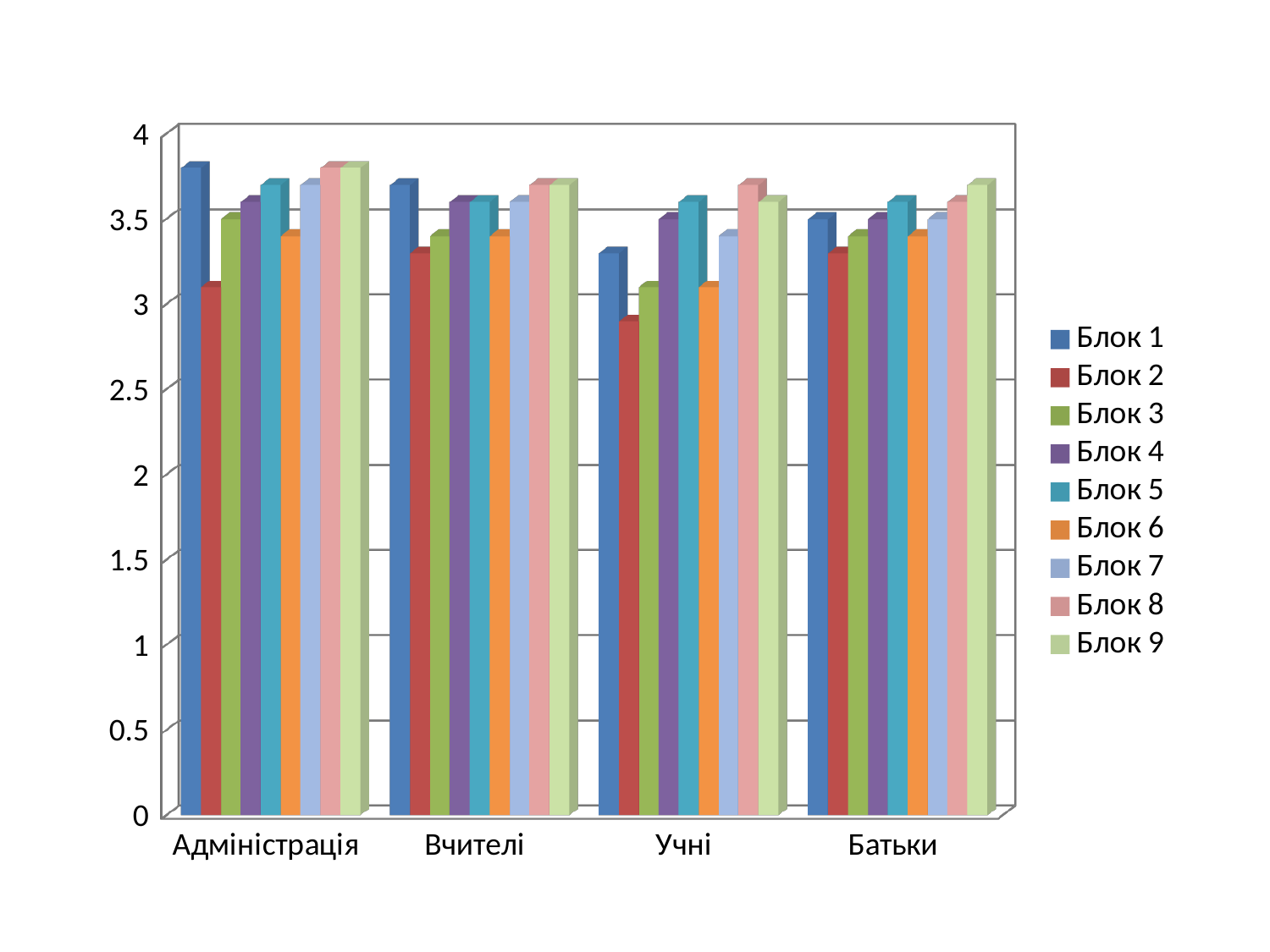
What kind of chart is shown on the slide? bar chart Which is larger: the value for Блок 8 in Учні or the value for Блок 2 in Учні? Блок 8 in Учні Which is larger: the value for Блок 1 in Адміністрація or the value for Блок 1 in Учні? Блок 1 in Адміністрація How many categories are shown along the x axis? 4 Is the value for Блок 1 in the Учні category greater or less than 3.5? less What is the label of the third category on the x axis? Учні Is the value for Блок 1 in the Адміністрація category greater or less than 3.5? greater Is the value for Блок 8 in the Адміністрація category greater or less than 3.5? greater How many series does the legend list? 9 Which series has the lowest value in the Учні category? Блок 2 Which series has the lowest value in the Адміністрація category? Блок 2